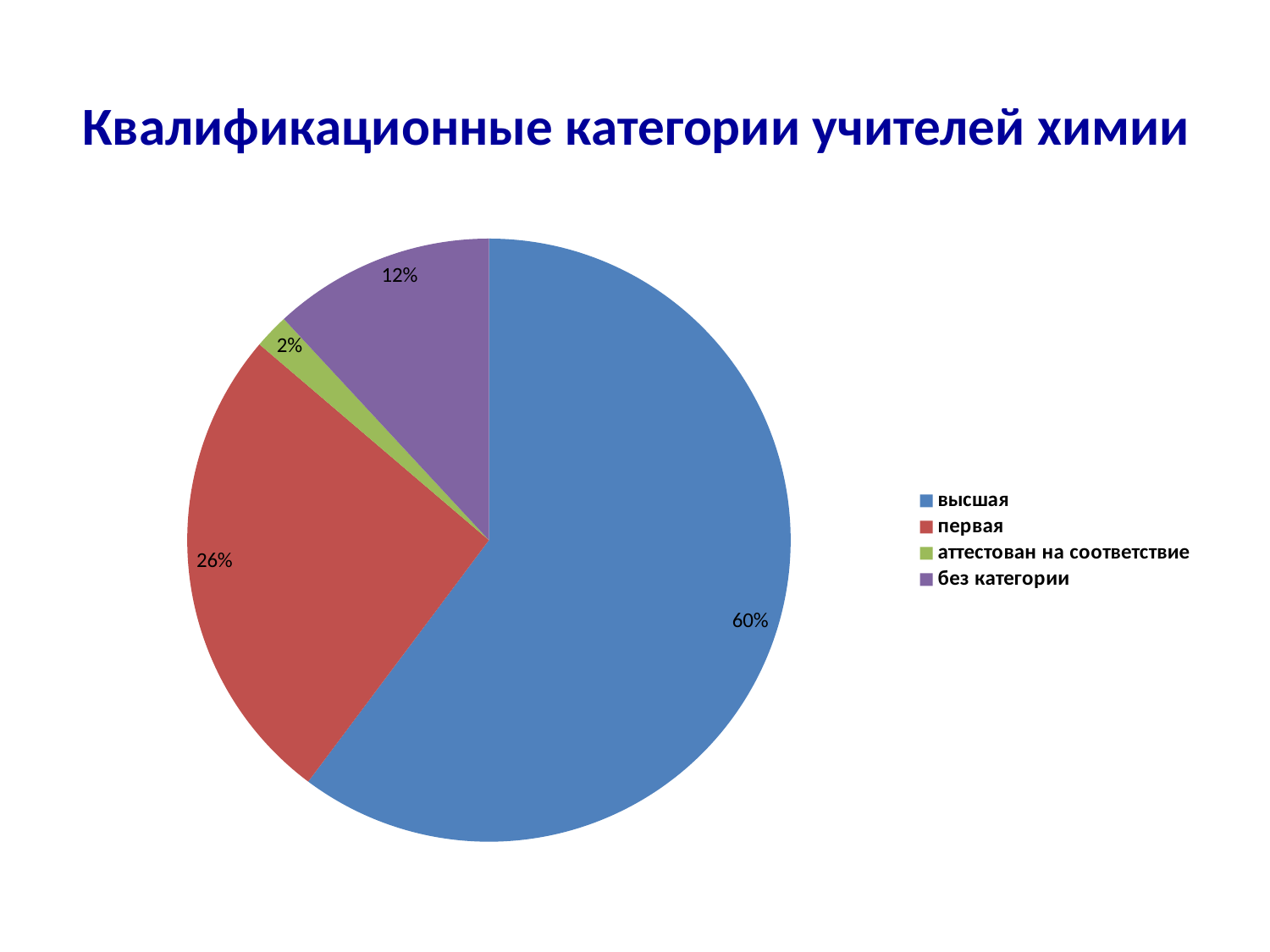
Which category has the smallest slice of the pie? аттестован на соответствие What share of the pie does the "высшая" category have? 60% What is the title of the chart on the slide? Квалификационные категории учителей химии What is the difference in percentage points between the "высшая" and "первая" slices? 34 What share of the pie does the "без категории" category have? 12% How many categories does the pie chart show? 4 What share of the pie does the "первая" category have? 26% What type of chart is shown on the slide? pie chart Which category has the largest slice of the pie? высшая Which slice is larger, "без категории" or "первая"? первая What colour is the slice for "без категории"? purple